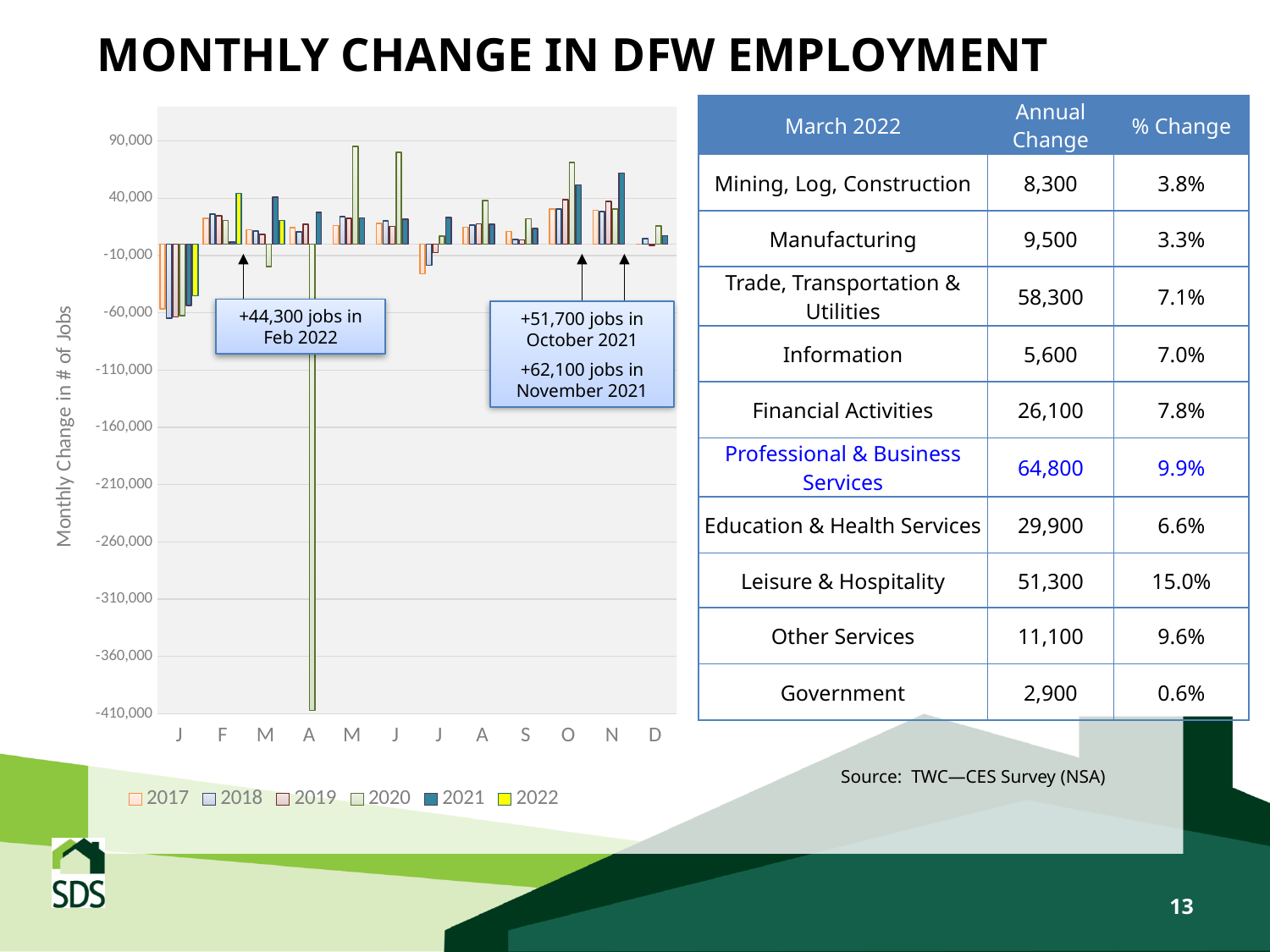
In which month does the chart show the lowest monthly change in employment? April (2020) How many series does the chart legend list? 6 What is the difference between the jobs added in November 2021 and October 2021, as annotated on the chart? 10,400 What is the label on the vertical axis of the chart? Monthly Change in # of Jobs Which month had the larger job gain according to the annotations: October 2021 or November 2021? November 2021 How many months are shown along the x axis of the chart? 12 What kind of chart is shown on the slide? bar chart According to the chart annotation, how many jobs were added in November 2021? +62,100 According to the chart annotation, how many jobs were added in February 2022? +44,300 Is the value for January 2017 greater or less than -10,000? less Is the value for April 2020 greater or less than -360,000? less According to the chart annotation, how many jobs were added in October 2021? +51,700